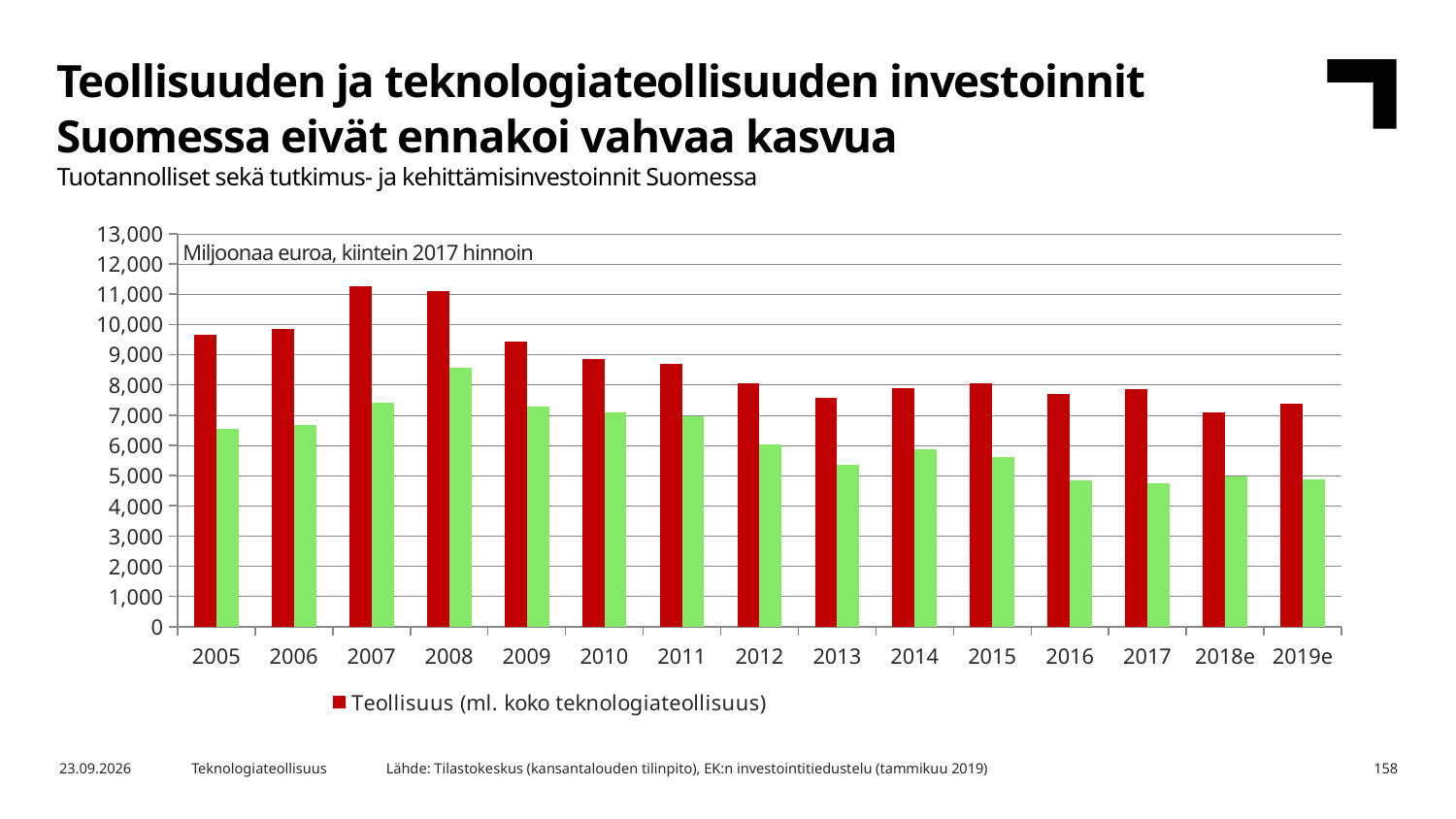
Is the red Teollisuus value for 2013 greater or less than 8,000? less What unit label is printed inside the plot area? Miljoonaa euroa, kiintein 2017 hinnoin In which year is the green bar highest? 2008 Which year has the larger red Teollisuus bar, 2007 or 2009? 2007 Is the red Teollisuus value for 2005 greater or less than 9,000? greater Is the green bar value for 2013 greater or less than 5,000? greater In which year is the red Teollisuus bar lowest? 2018e What is the name of the series shown in the legend? Teollisuus (ml. koko teknologiateollisuus) How many series does the legend list? 1 What kind of chart is shown on the slide? bar chart Do the red Teollisuus bars generally rise or fall from 2005 to 2019e? fall How many years (categories) are shown on the x axis? 15